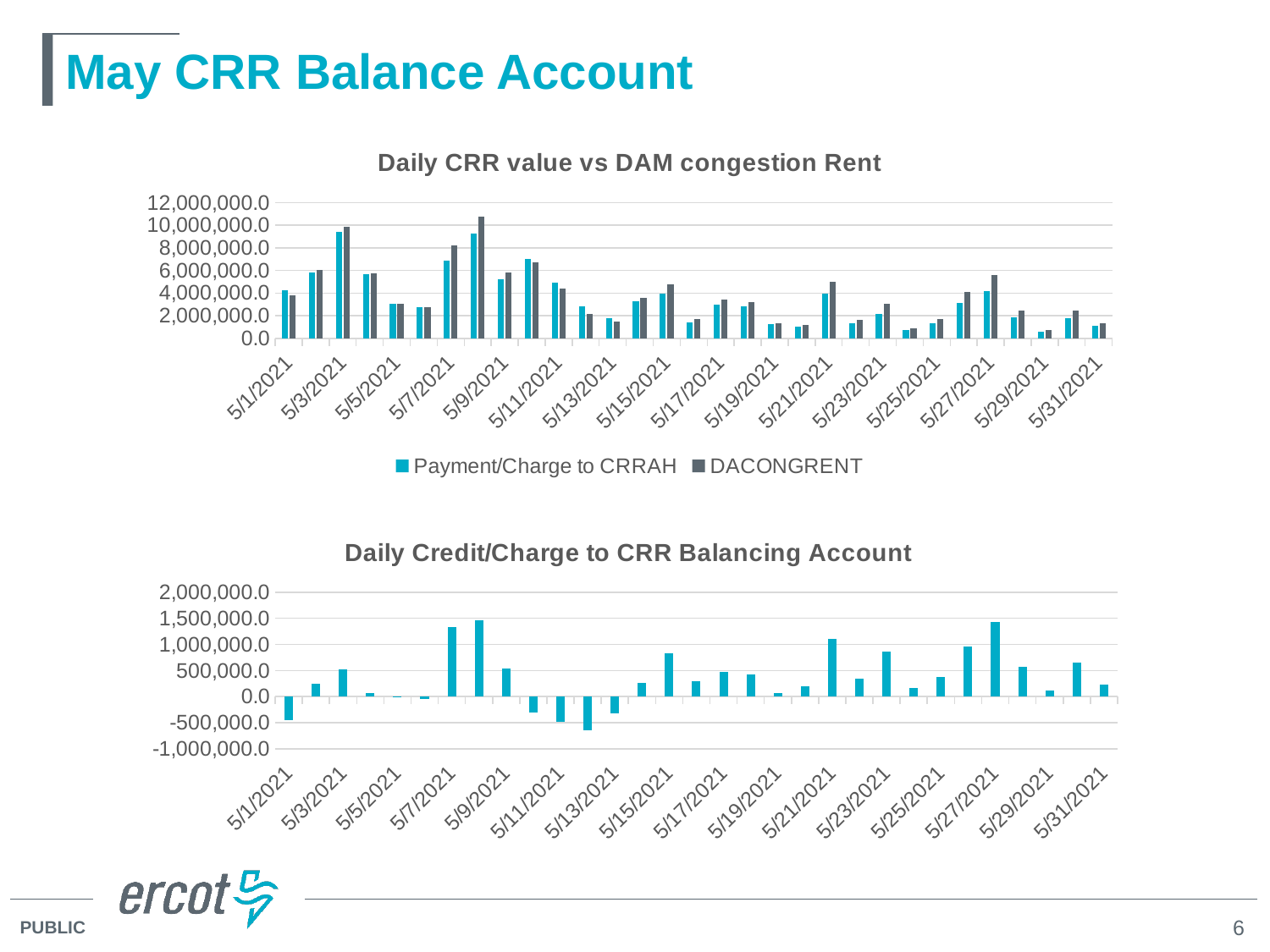
In the top chart, 'Daily CRR value vs DAM congestion Rent', do the values generally rise or fall from 5/9/2021 to 5/13/2021? fall In the bottom chart, 'Daily Credit/Charge to CRR Balancing Account', which date has the larger value, 5/11/2021 or 5/15/2021? 5/15/2021 In the top chart, 'Daily CRR value vs DAM congestion Rent', is the DACONGRENT value for 5/3/2021 greater or less than 8,000,000.0? greater In the top chart, 'Daily CRR value vs DAM congestion Rent', which series has the larger value on 5/7/2021, Payment/Charge to CRRAH or DACONGRENT? DACONGRENT What is the title of the bottom chart on the slide? Daily Credit/Charge to CRR Balancing Account In the bottom chart, 'Daily Credit/Charge to CRR Balancing Account', is the value for 5/1/2021 greater or less than 0.0? less How many series does the legend of the top chart, 'Daily CRR value vs DAM congestion Rent', list? 2 What kind of chart is the top chart, 'Daily CRR value vs DAM congestion Rent'? bar chart In the top chart, 'Daily CRR value vs DAM congestion Rent', is the Payment/Charge to CRRAH value for 5/1/2021 greater or less than 6,000,000.0? less In the top chart, 'Daily CRR value vs DAM congestion Rent', which series has the larger value on 5/27/2021, Payment/Charge to CRRAH or DACONGRENT? DACONGRENT In the top chart, 'Daily CRR value vs DAM congestion Rent', what are the two series named in the legend? Payment/Charge to CRRAH and DACONGRENT